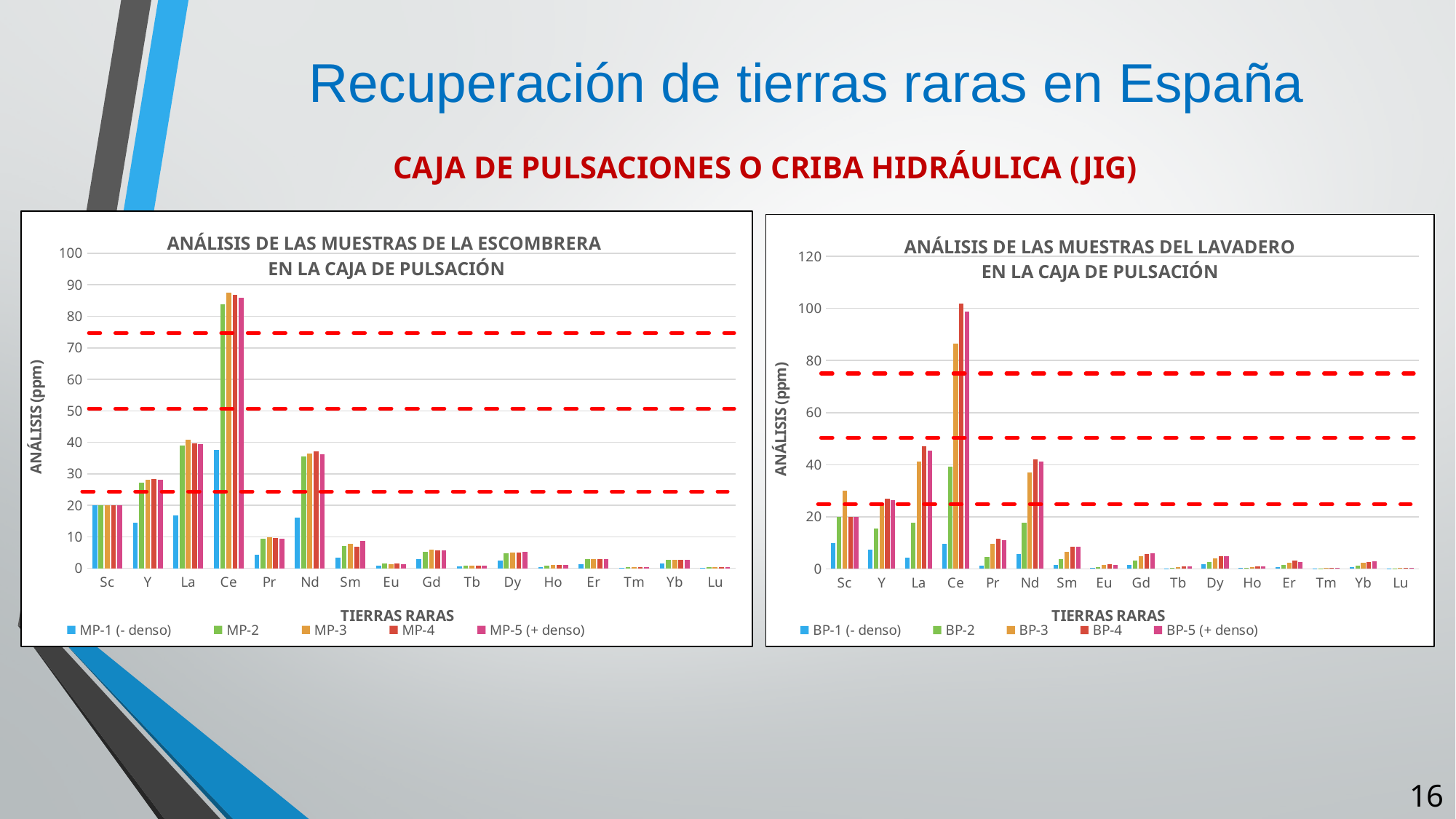
In the left chart (escombrera), which is larger for MP-3: the value for Ce or the value for Nd? Ce What kind of chart is the left chart, 'ANÁLISIS DE LAS MUESTRAS DE LA ESCOMBRERA EN LA CAJA DE PULSACIÓN'? bar chart In the left chart (escombrera), is the value of MP-3 for Ce greater or less than 80? greater In the left chart (escombrera), how many series does the legend list? 5 In the right chart (lavadero), how many series does the legend list? 5 In the left chart (escombrera), is the value of MP-1 (- denso) for Ce greater or less than 30? greater In the right chart (lavadero), which rare-earth category has the highest bars? Ce In the right chart (lavadero), which is larger for BP-3: the value for Y or the value for La? La In the right chart (lavadero), is the value of BP-1 (- denso) for Sc greater or less than 20? less In the left chart (escombrera), which rare-earth category has the highest bars? Ce In the left chart (escombrera), how many rare-earth categories are shown on the x axis? 16